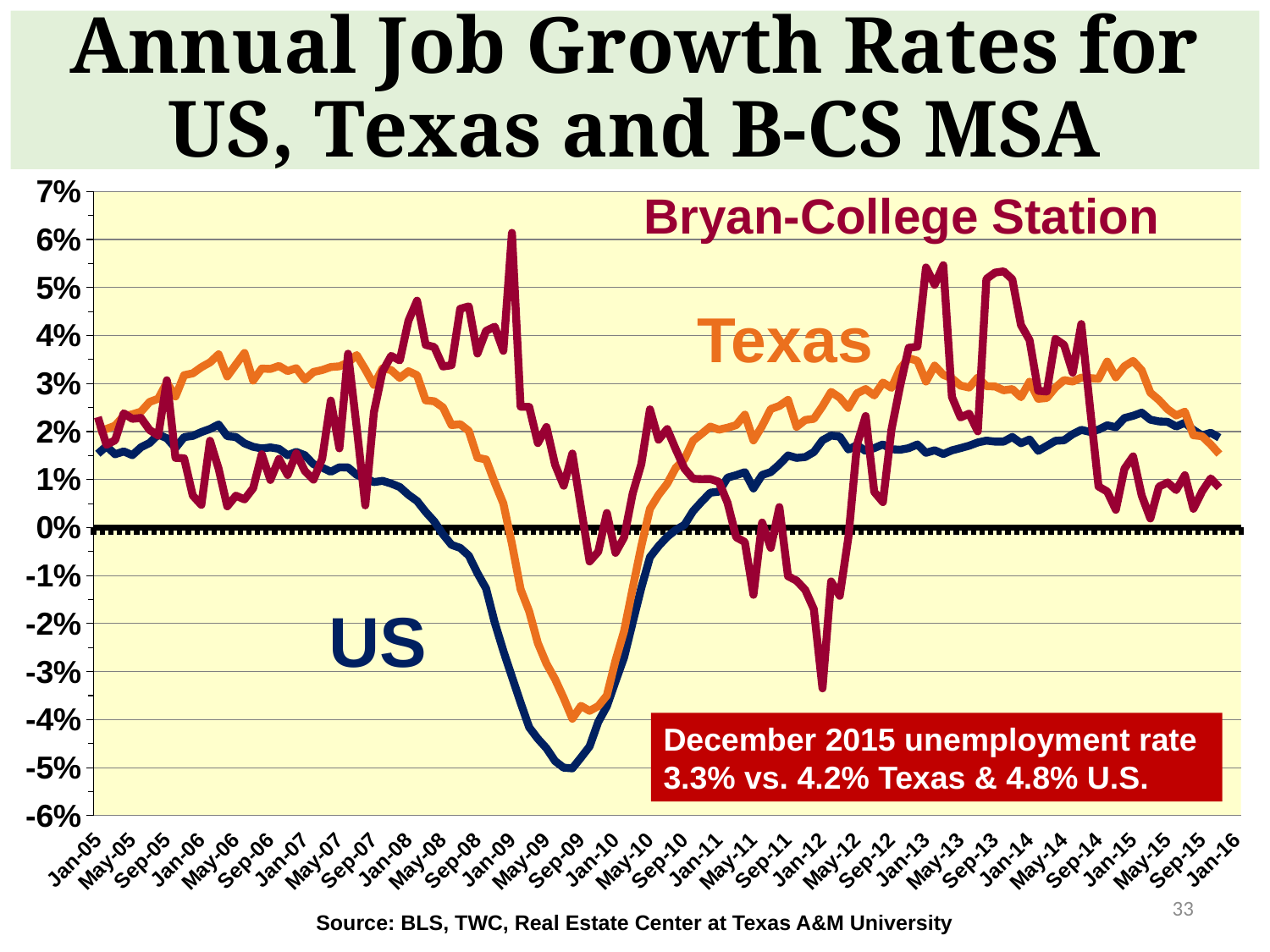
Is the value for US around Sep-09 greater or less than -4%? less What kind of chart is shown on the slide? Line chart What is the title of the chart on the slide? Annual Job Growth Rates for US, Texas and B-CS MSA Does the US series rise or fall between Jan-08 and Sep-09? Fall Which series is drawn in orange? Texas Around Sep-09, which series has the lower value, US or Texas? US Is the value for Bryan-College Station around Jan-12 greater or less than -2%? less Which series reaches the lowest value anywhere on the chart? US Which series reaches the highest value anywhere on the chart? Bryan-College Station Is the peak value for Bryan-College Station around Jan-09 greater or less than 5%? greater How many series are plotted on the chart? 3